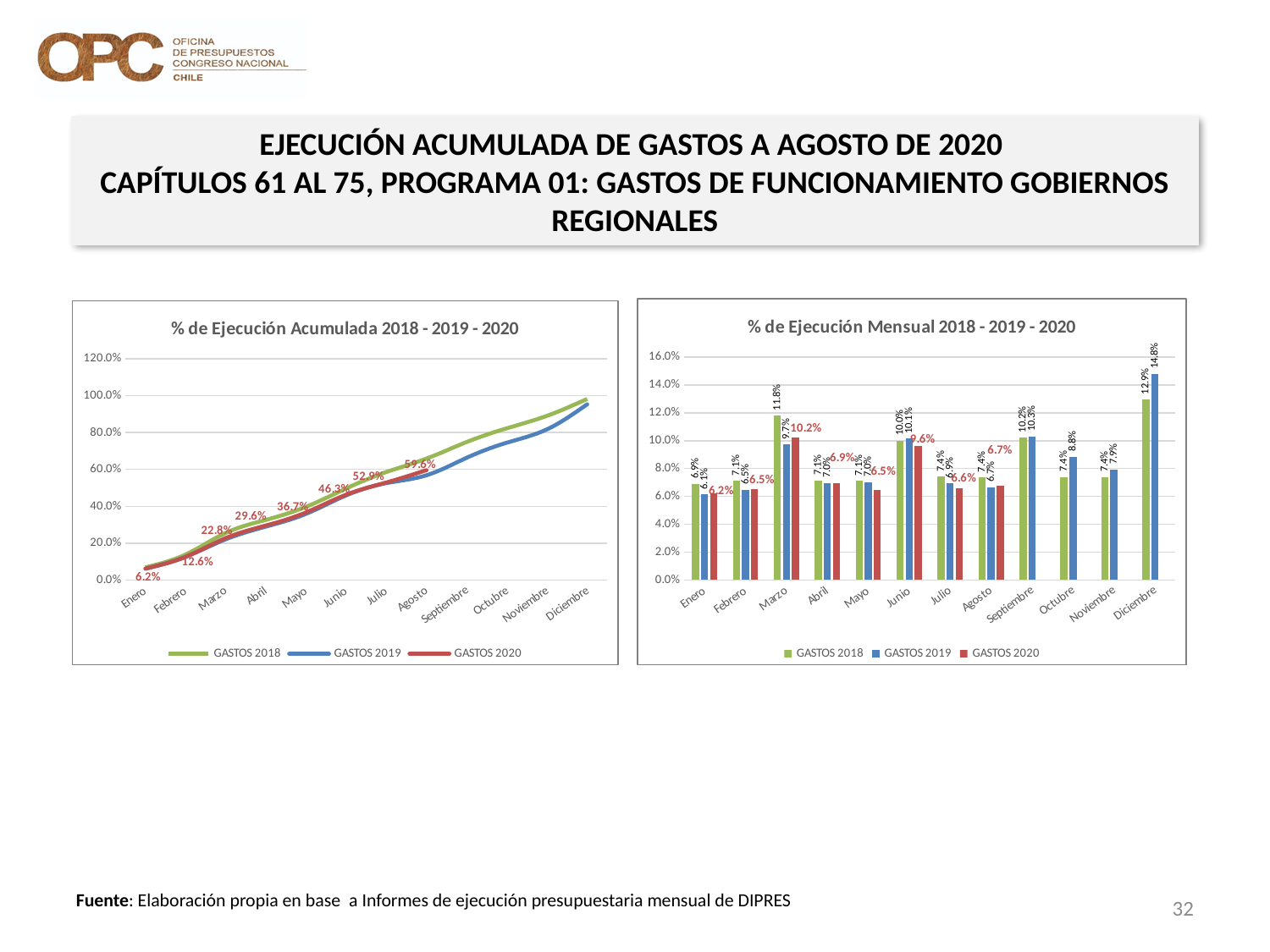
How many series does the legend of the left chart '% de Ejecución Acumulada' list? 3 In the left chart '% de Ejecución Acumulada', what is the GASTOS 2020 value for Marzo? 22.8% In the right chart '% de Ejecución Mensual', how many months are shown on the x axis? 12 In the left chart '% de Ejecución Acumulada', what is the GASTOS 2020 value for Agosto? 59.6% What kind of chart is the left chart titled '% de Ejecución Acumulada 2018 - 2019 - 2020'? Line chart In the right chart '% de Ejecución Mensual', which month has the highest GASTOS 2020 value? Marzo In the left chart '% de Ejecución Acumulada', what is the difference between the GASTOS 2020 values for Agosto and Julio? 6.7 percentage points In the left chart '% de Ejecución Acumulada', does the GASTOS 2020 line rise or fall from Enero to Agosto? Rises In the right chart '% de Ejecución Mensual', what is the GASTOS 2018 value for Marzo? 11.8% In the right chart '% de Ejecución Mensual', what is the difference between the GASTOS 2018 and GASTOS 2019 values for Marzo? 2.1 percentage points What kind of chart is the right chart titled '% de Ejecución Mensual 2018 - 2019 - 2020'? Bar chart In the right chart '% de Ejecución Mensual', what is the GASTOS 2019 value for Diciembre? 14.8%